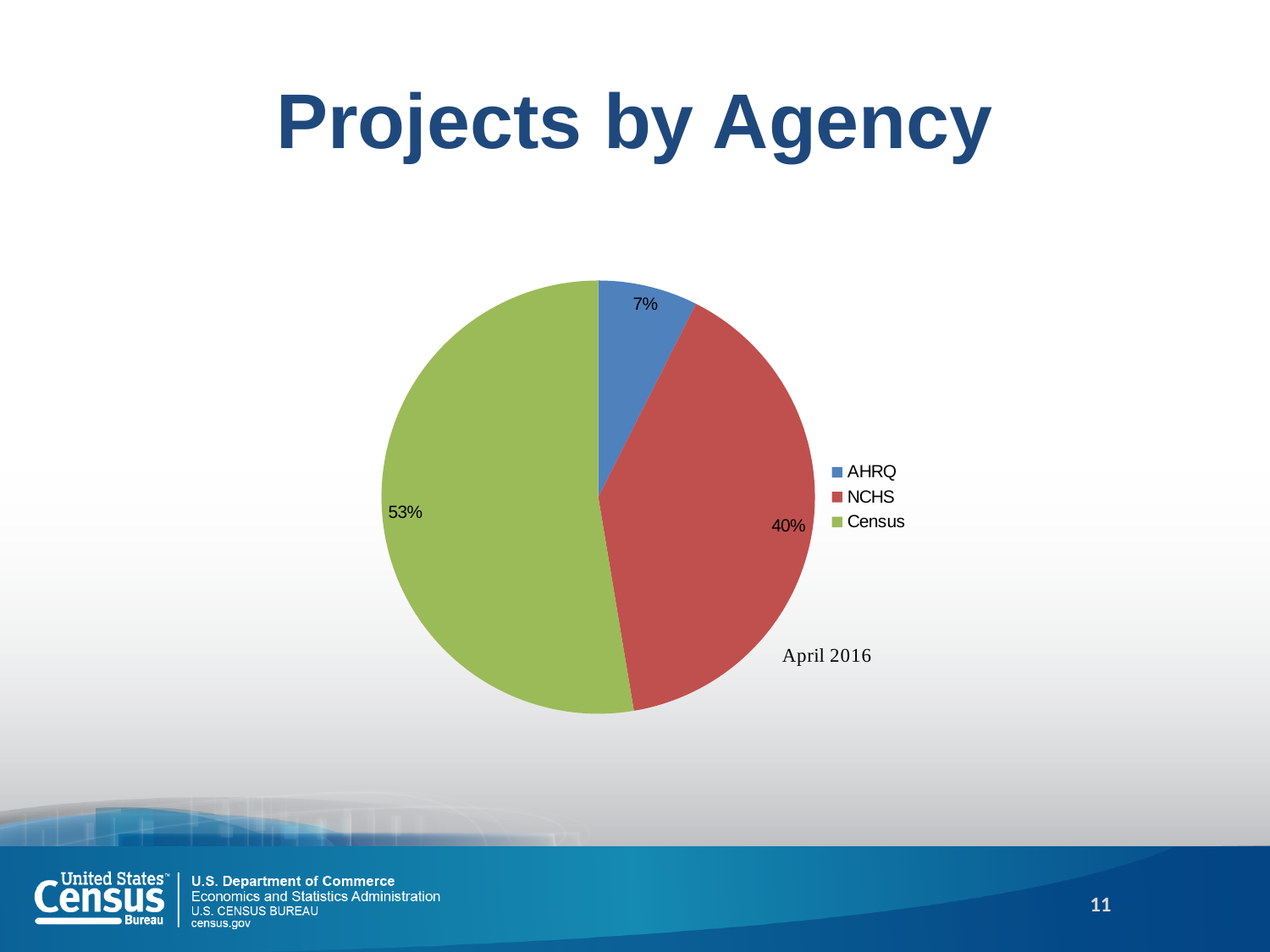
Which colour represents Census in the pie chart? Green What is the difference in percentage points between the Census share and the NCHS share? 13 What is the title of the chart on the slide? Projects by Agency Which agency has the smallest share of projects? AHRQ Which agency has the largest share of projects? Census What share of projects does AHRQ account for in the pie chart? 7% What kind of chart is shown on the slide? Pie chart What share of projects does Census account for in the pie chart? 53% How many agencies are shown in the pie chart? 3 What share of projects does NCHS account for in the pie chart? 40% What is the difference in percentage points between the NCHS share and the AHRQ share? 33 Which has a larger share of projects, NCHS or AHRQ? NCHS